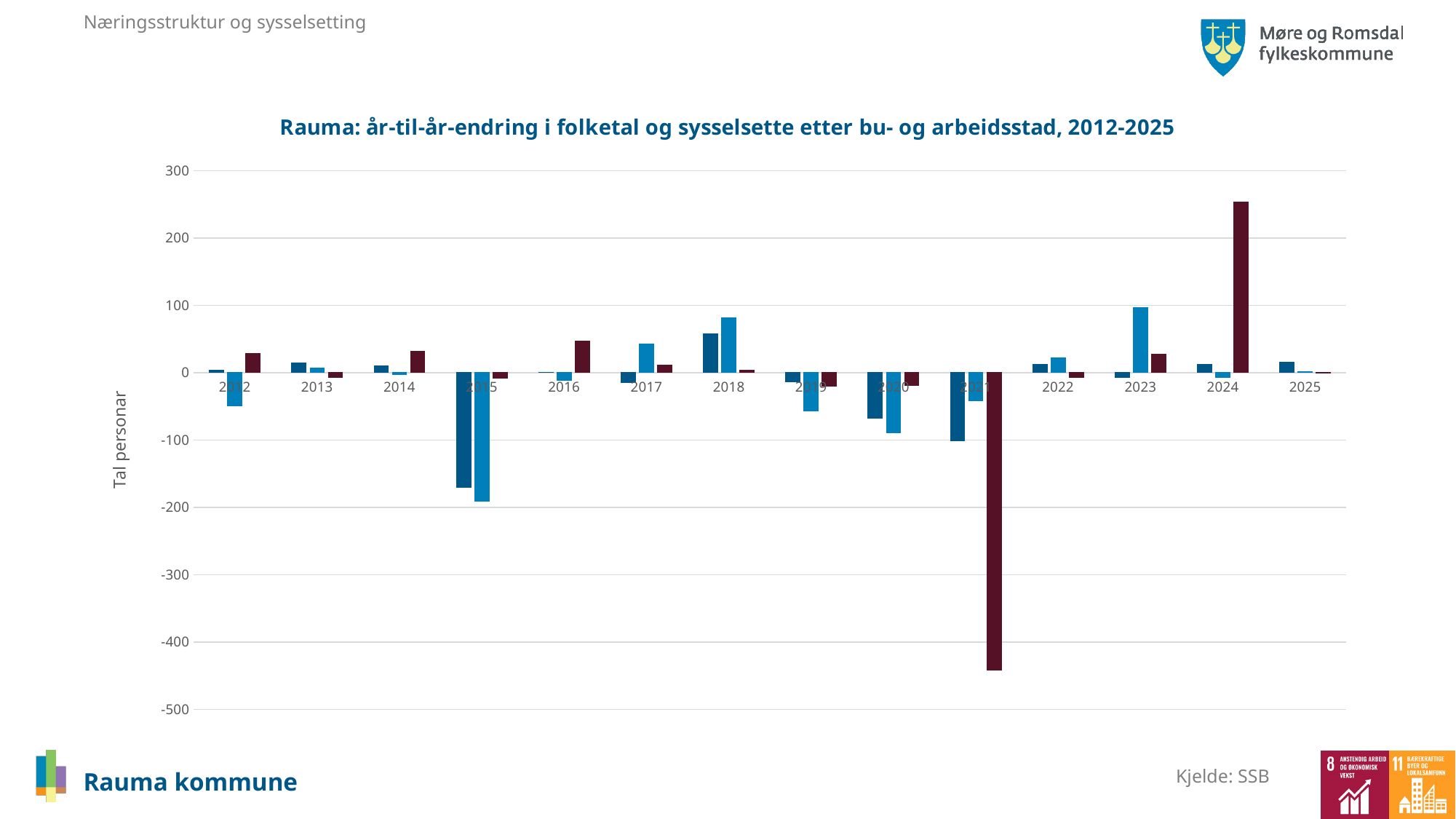
In which year is the light blue bar the highest? 2023 In which year is the dark red bar the lowest? 2021 In which year is the dark red bar the highest? 2024 How many bars are plotted for each year in the chart? 3 Is the value of the dark red bar for 2024 greater or less than 200? greater How many years are shown along the x axis of the chart? 14 In 2018, which bar is taller, the dark blue bar or the light blue bar? the light blue bar What is the title of the chart? Rauma: år-til-år-endring i folketal og sysselsette etter bu- og arbeidsstad, 2012-2025 What kind of chart is shown on the slide? bar chart What is the label on the vertical axis of the chart? Tal personar Is the value of the dark red bar for 2021 greater or less than -400? less In which year is the light blue bar the lowest? 2015